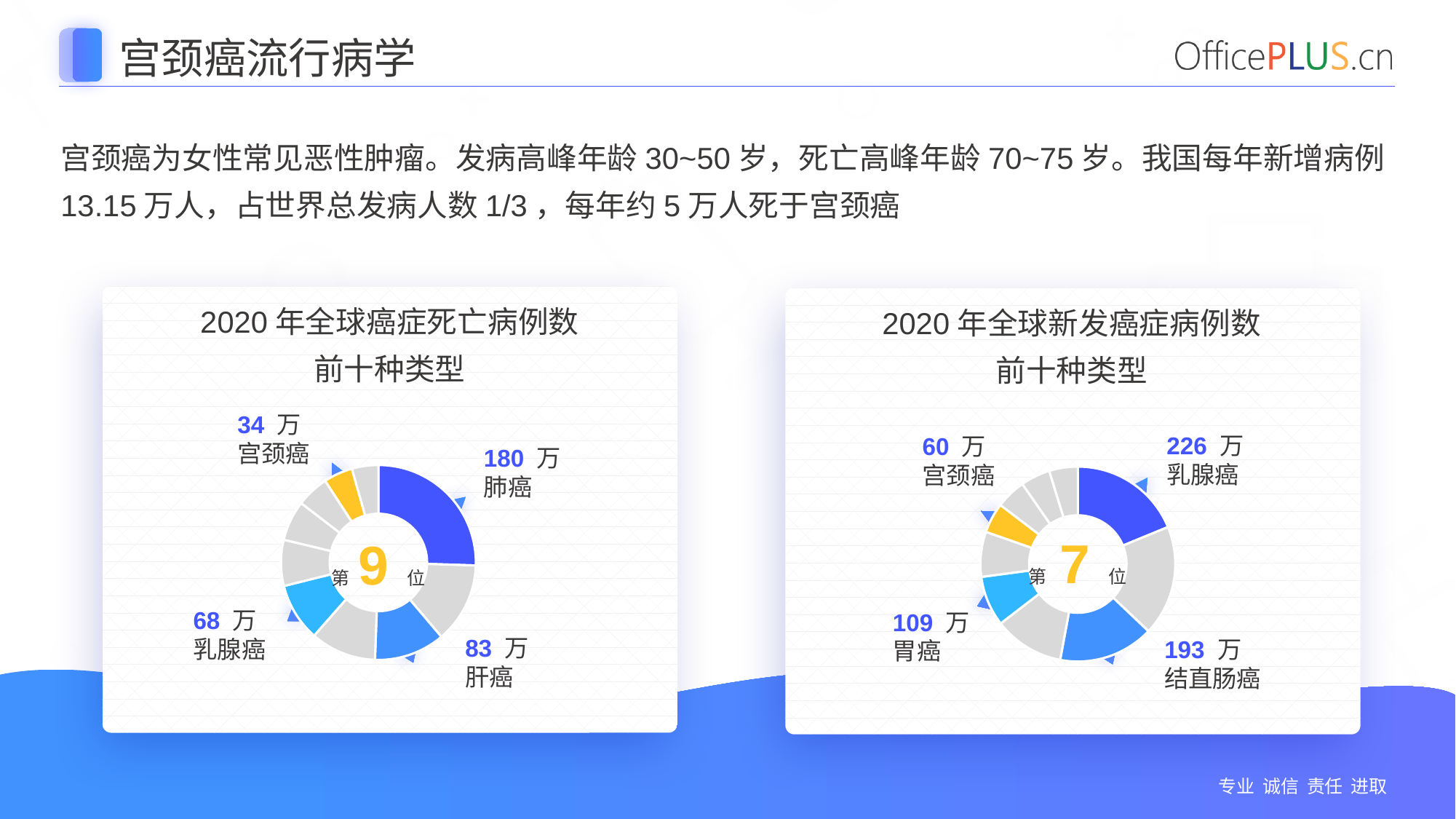
In the right chart (2020 年全球新发癌症病例数前十种类型), what is the value labelled for 胃癌? 109 万 In the right chart (2020 年全球新发癌症病例数前十种类型), which of the labelled cancer types has the lowest value? 宫颈癌 In the right chart (2020 年全球新发癌症病例数前十种类型), what is the difference between the values for 乳腺癌 and 结直肠癌? 33 万 In the left chart (2020 年全球癌症死亡病例数前十种类型), what is the value labelled for 肺癌? 180 万 What kind of chart is used on the left side of the slide (2020 年全球癌症死亡病例数前十种类型)? Donut (pie) chart In the right chart (2020 年全球新发癌症病例数前十种类型), what is the value labelled for 乳腺癌? 226 万 What rank is shown in the centre of the right chart (2020 年全球新发癌症病例数前十种类型)? 第 7 位 In the left chart (2020 年全球癌症死亡病例数前十种类型), which of the labelled cancer types has the highest value? 肺癌 In the right chart (2020 年全球新发癌症病例数前十种类型), which is larger, the value for 结直肠癌 or the value for 胃癌? 结直肠癌 What rank is shown in the centre of the left chart (2020 年全球癌症死亡病例数前十种类型)? 第 9 位 In the left chart (2020 年全球癌症死亡病例数前十种类型), what is the value labelled for 宫颈癌? 34 万 In the left chart (2020 年全球癌症死亡病例数前十种类型), what is the difference between the values for 肝癌 and 乳腺癌? 15 万